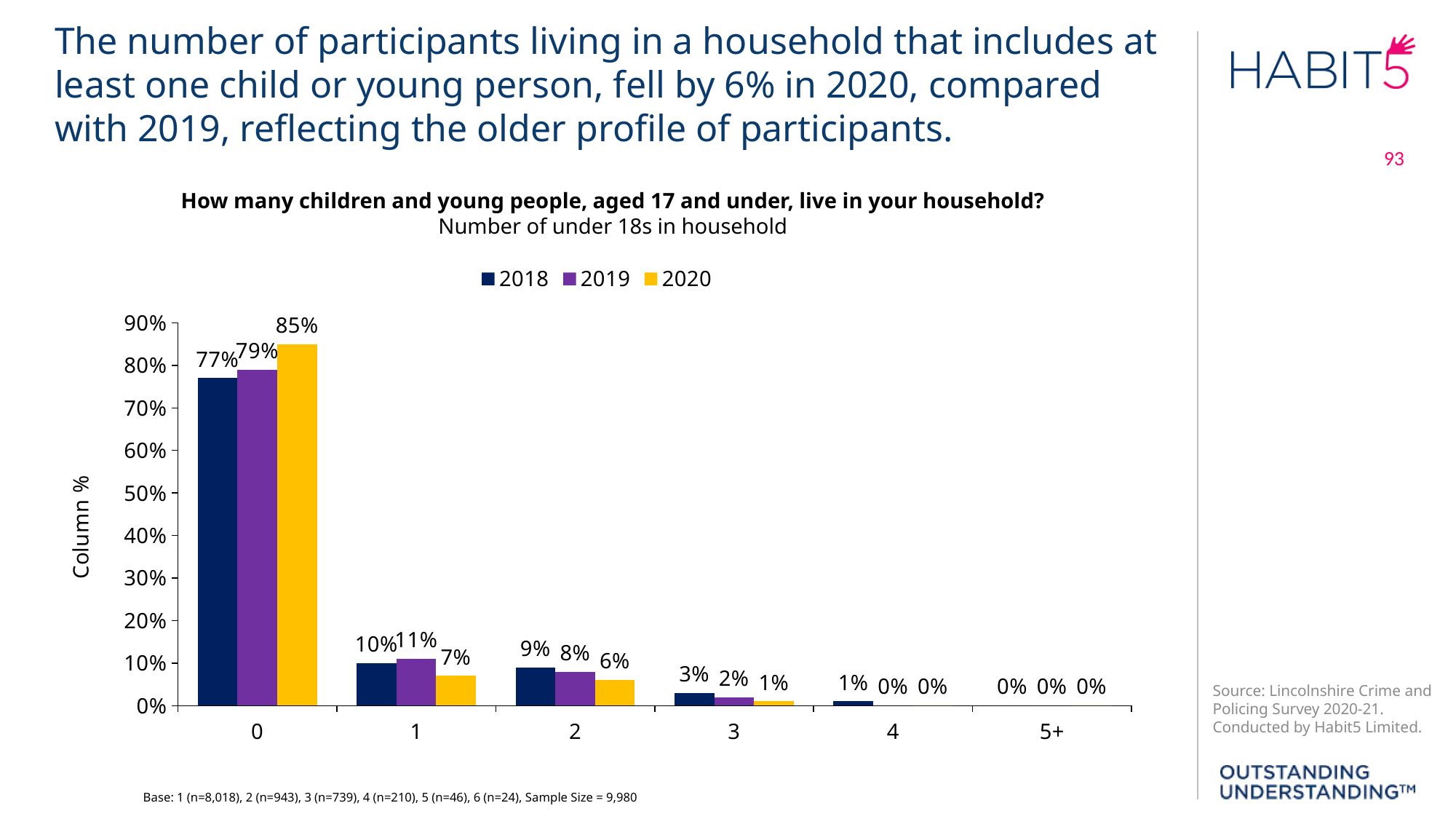
How many series does the legend list? 3 What is the 2019 value for the '2' category? 8% What is the 2020 value for the '0' category? 85% How many categories are shown on the x axis? 6 What is the 2018 value for the '4' category? 1% Which category has the highest value for the 2019 series? 0 What is the label of the y axis? Column % What is the difference between the 2020 and 2018 values for the '0' category? 8% What is the 2018 value for the '1' category? 10% Is the 2018 value for the '0' category greater or less than 70%? greater Which is larger for the '1' category, the 2019 value or the 2020 value? 2019 What kind of chart is shown on the slide? Bar chart